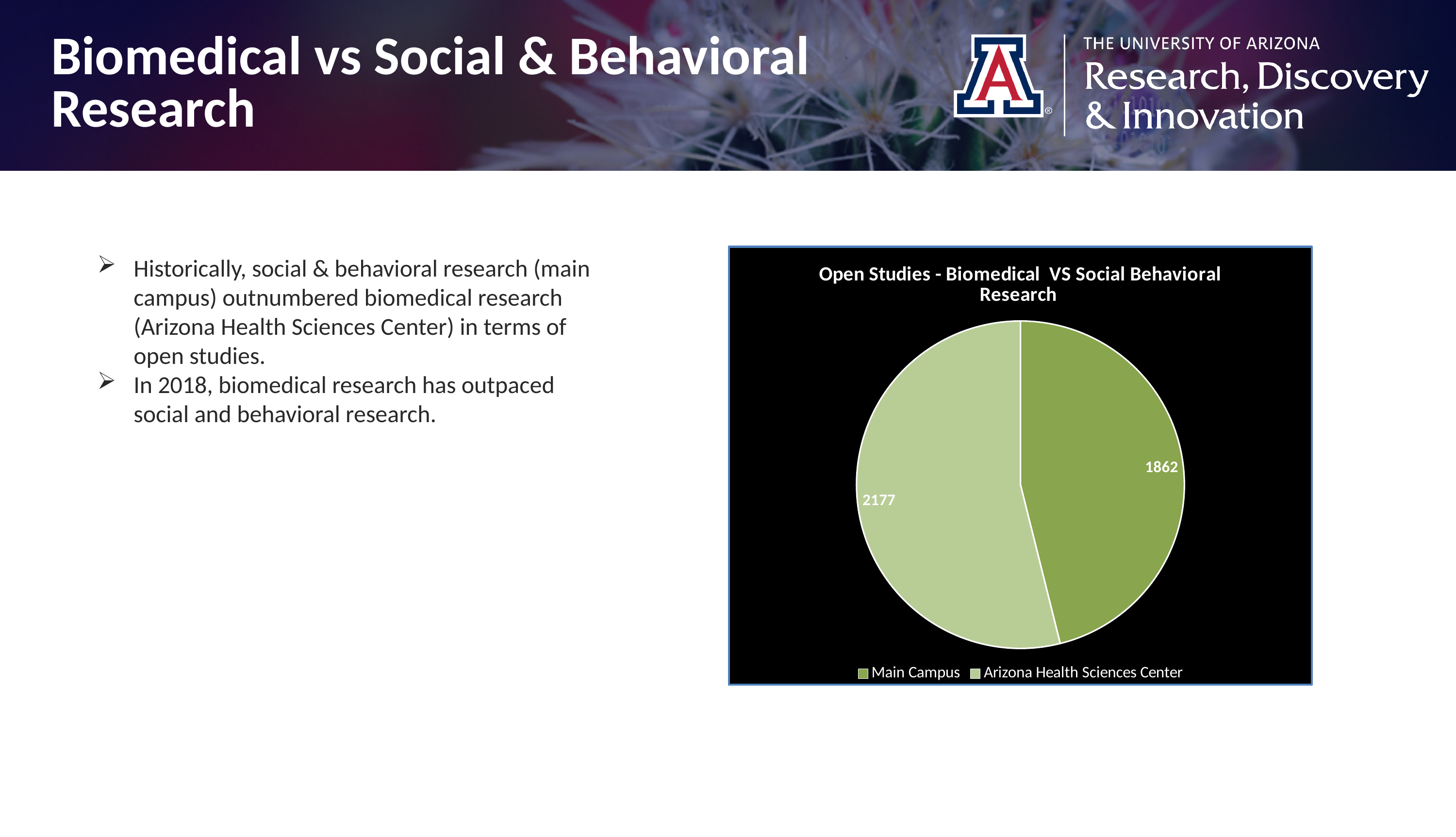
What is the difference between the Arizona Health Sciences Center value and the Main Campus value? 315 How many open studies does the chart show for Main Campus? 1862 What is the title of the chart? Open Studies - Biomedical VS Social Behavioral Research What is the total of the two values shown in the pie chart? 4039 What share of the pie does the Arizona Health Sciences Center slice represent, to one decimal place? 53.9% Which category has the larger slice of the pie? Arizona Health Sciences Center How many entries does the chart legend list? 2 Is the value for Main Campus larger or smaller than the value for Arizona Health Sciences Center? Smaller How many open studies does the chart show for Arizona Health Sciences Center? 2177 How many slices does the pie chart have? 2 What type of chart is shown on the slide? Pie chart Which category has the smaller slice of the pie? Main Campus